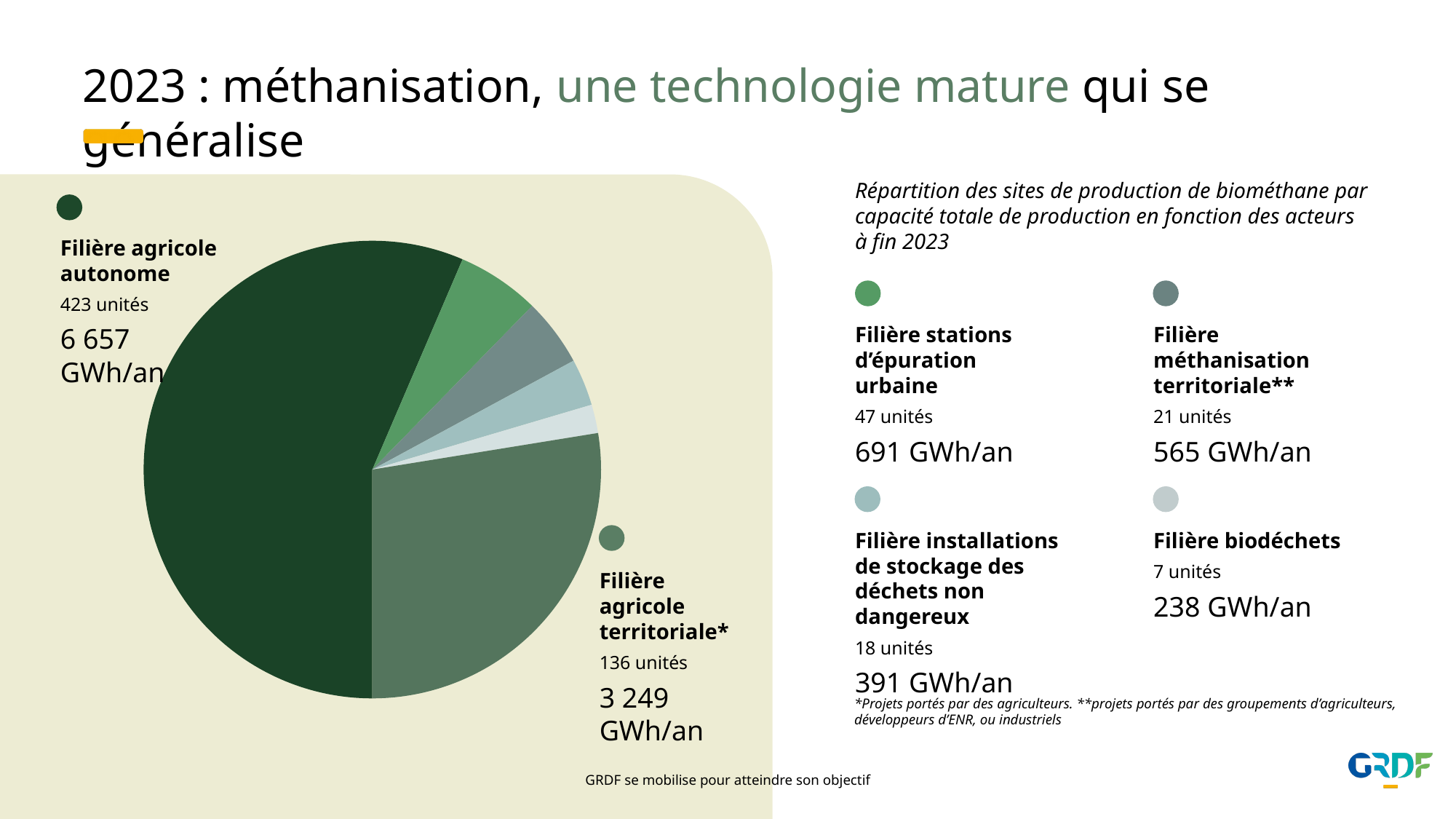
What is the production capacity of the Filière installations de stockage des déchets non dangereux? 391 GWh/an What kind of chart is shown on the slide? Pie chart How many units does the Filière agricole territoriale* have? 136 unités Which filière has the largest share of the pie chart? Filière agricole autonome What is the difference in production capacity between the Filière agricole autonome and the Filière agricole territoriale*? 3 408 GWh/an What is the difference in number of units between the Filière agricole autonome and the Filière agricole territoriale*? 287 unités Which filière has the smallest production capacity? Filière biodéchets How many categories (filières) does the pie chart show? 6 Which has the larger production capacity: Filière stations d'épuration urbaine or Filière méthanisation territoriale**? Filière stations d'épuration urbaine How many units does the Filière biodéchets have? 7 unités What is the production capacity of the Filière agricole autonome? 6 657 GWh/an What is the production capacity of the Filière stations d'épuration urbaine? 691 GWh/an